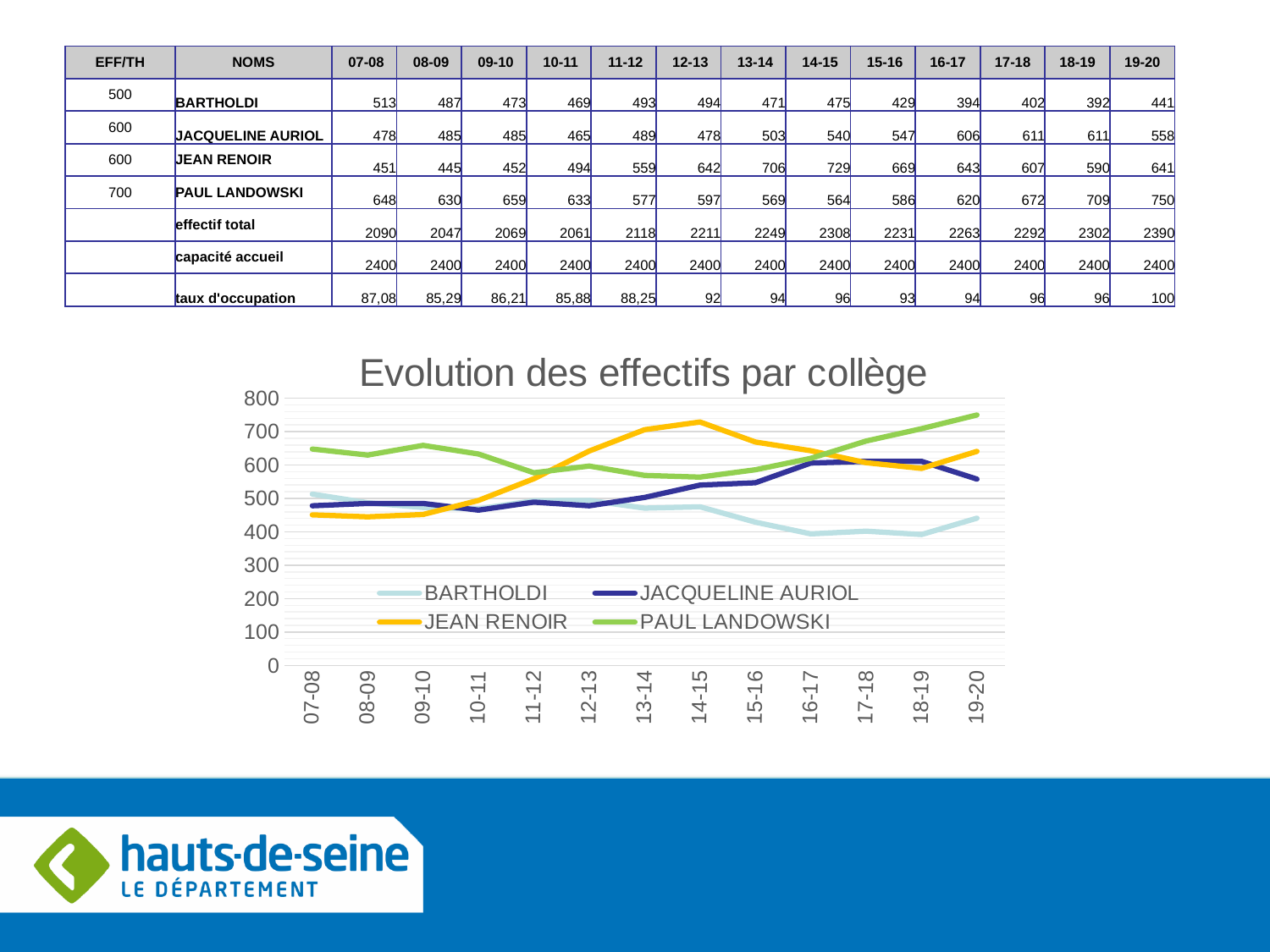
According to the slide, which is larger in 16-17: JACQUELINE AURIOL or JEAN RENOIR? JEAN RENOIR What is the title of the line chart on the slide? Evolution des effectifs par collège How many school years are shown along the x axis of the chart "Evolution des effectifs par collège"? 13 What kind of chart is "Evolution des effectifs par collège"? line chart How many series does the legend of the chart "Evolution des effectifs par collège" list? 4 According to the slide, what is the difference between the JEAN RENOIR value and the BARTHOLDI value in 19-20? 200 In the chart "Evolution des effectifs par collège", does the PAUL LANDOWSKI line rise or fall from 14-15 to 19-20? rise According to the slide, what is the value for PAUL LANDOWSKI in 19-20? 750 In the chart "Evolution des effectifs par collège", what colour is the BARTHOLDI line? light blue In the chart "Evolution des effectifs par collège", is the value for JEAN RENOIR in 14-15 greater or less than 700? greater In the chart "Evolution des effectifs par collège", which collège has the highest value in 19-20? PAUL LANDOWSKI In the chart "Evolution des effectifs par collège", which collège has the lowest value in 19-20? BARTHOLDI